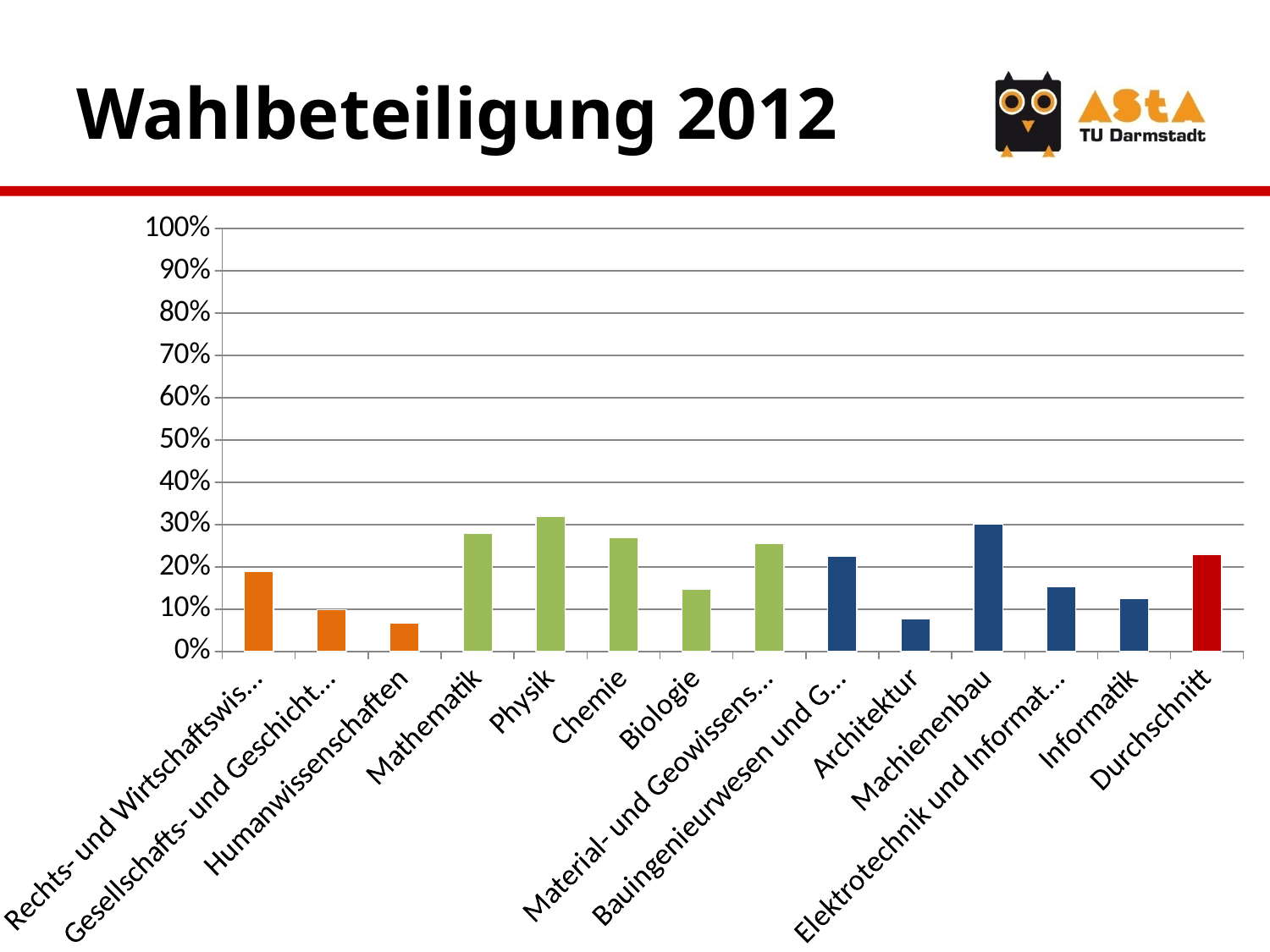
What is the title of the slide containing the chart? Wahlbeteiligung 2012 Is the value for Biologie greater or less than 20%? less What colour is the bar for Durchschnitt? red Is the value for Physik greater or less than 30%? greater Is the value for Machienenbau greater or less than 20%? greater Which is larger, the value for Physik or the value for Biologie? Physik Which is larger, the value for Mathematik or the value for Informatik? Mathematik What kind of chart is shown on the slide? bar chart Which category has the highest value in the chart? Physik How many bars (categories) are plotted in the chart? 14